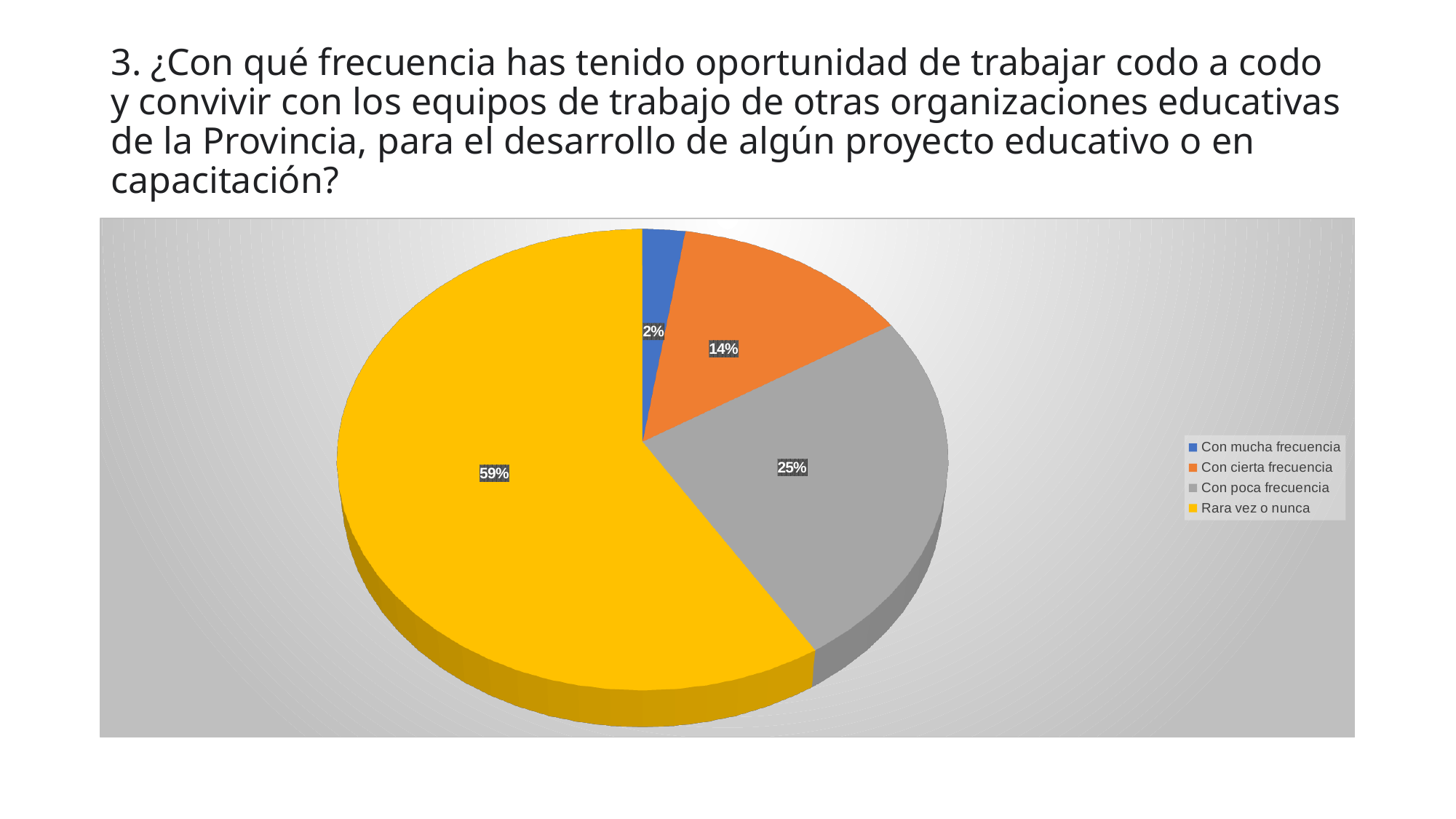
What percentage of the pie corresponds to "Con poca frecuencia"? 25% Which category has the smallest share of the pie? Con mucha frecuencia How many categories does the pie chart have? 4 What is the difference in percentage points between "Rara vez o nunca" and "Con poca frecuencia"? 34 What percentage of the pie corresponds to "Rara vez o nunca"? 59% Which category has the largest share of the pie? Rara vez o nunca What type of chart is shown on the slide? Pie chart What percentage of the pie corresponds to "Con cierta frecuencia"? 14% What colour is the slice for "Con cierta frecuencia"? Orange What is the combined share of "Con mucha frecuencia" and "Con cierta frecuencia"? 16% Which is larger: the share for "Con cierta frecuencia" or the share for "Con poca frecuencia"? Con poca frecuencia What percentage of the pie corresponds to "Con mucha frecuencia"? 2%